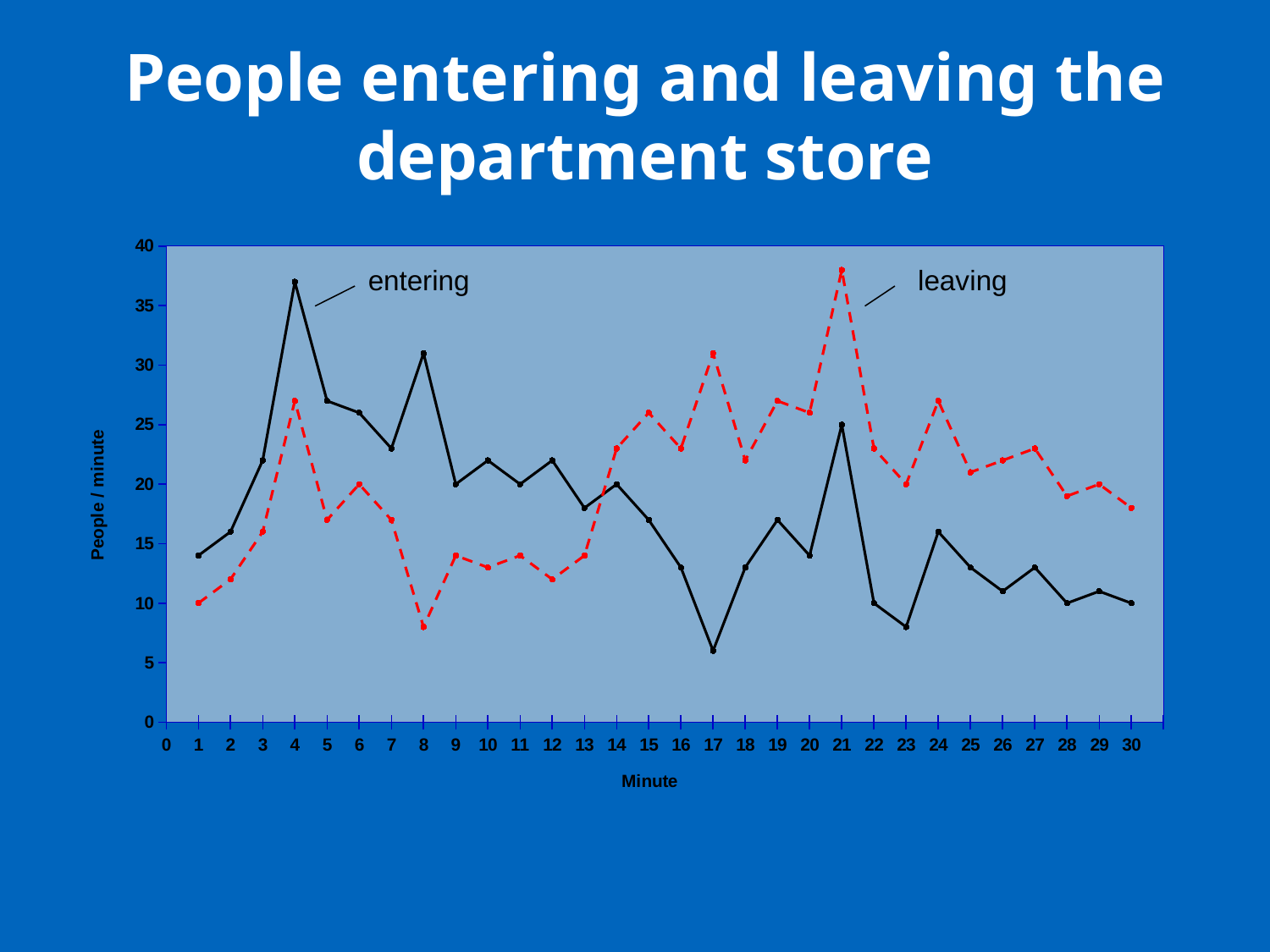
At minute 8, which series has the larger value, entering or leaving? entering At which minute does the leaving series reach its lowest value? 8 At which minute does the entering series reach its highest value? 4 At minute 21, which series has the larger value, entering or leaving? leaving At which minute does the leaving series reach its highest value? 21 At which minute does the entering series reach its lowest value? 17 Which series is drawn as a red dashed line? leaving What kind of chart is shown on the slide? line chart How many series are plotted on the chart? 2 Is the value for entering at minute 17 greater or less than 10? less Is the value for entering at minute 4 greater or less than 35? greater Is the value for leaving at minute 8 greater or less than 10? less